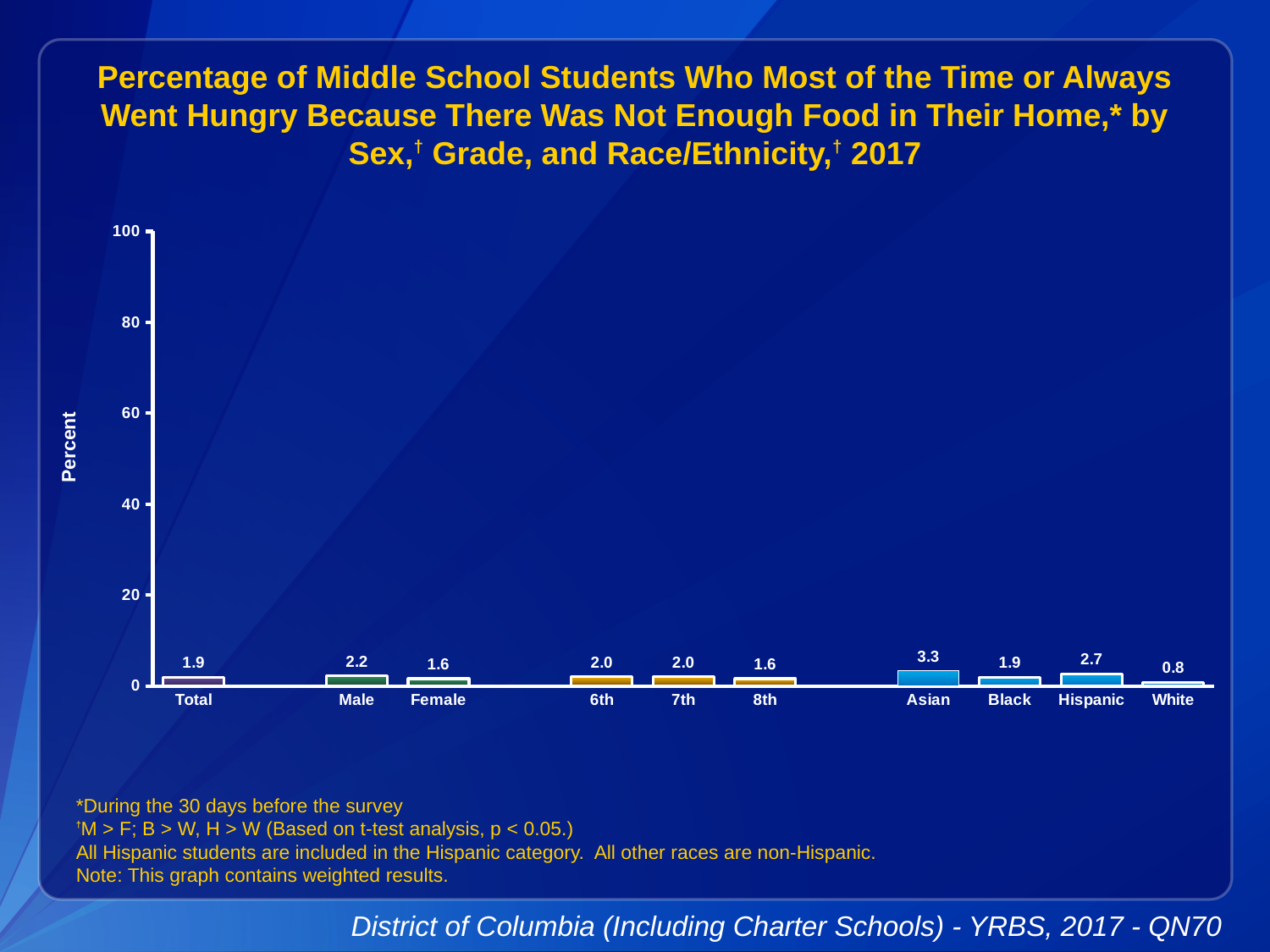
Is the value for Asian greater or less than 20? less What is the difference between the values for Male and Female? 0.6 How many categories are shown on the x axis? 10 What is the value for Male? 2.2 What is the value for White? 0.8 Which category has the lowest value? White What is the value for Asian? 3.3 What is the value for Total? 1.9 Which is larger, the value for Hispanic or the value for Black? Hispanic What kind of chart is shown on the slide? bar chart What is the value for Female? 1.6 Which category has the highest value? Asian